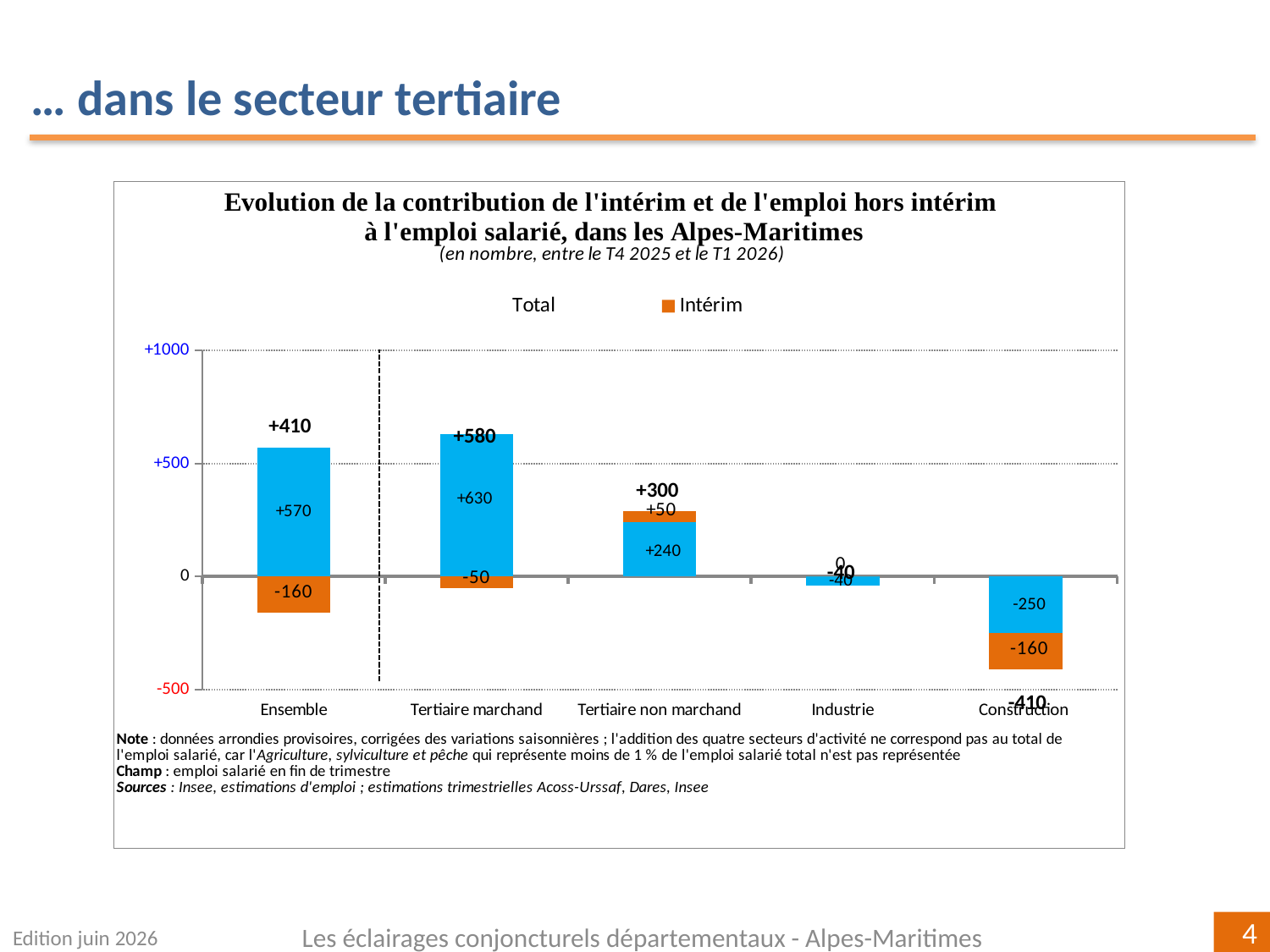
What is the total value shown for Industrie? -40 Which category has the highest total value? Tertiaire marchand What is the value of the blue bar for Tertiaire non marchand? +240 What is the Intérim value for Ensemble? -160 What is the total value shown for Tertiaire marchand? +580 What is the difference between the total for Ensemble (+410) and the total for Construction (-410)? 820 How many series does the chart legend list? 2 How many sector categories are shown on the x axis of the chart? 5 What kind of chart is shown on the slide? bar chart What is the Intérim value for Tertiaire non marchand? +50 Which category has the lowest total value? Construction Which is larger, the Intérim value for Ensemble or the Intérim value for Tertiaire marchand? Tertiaire marchand